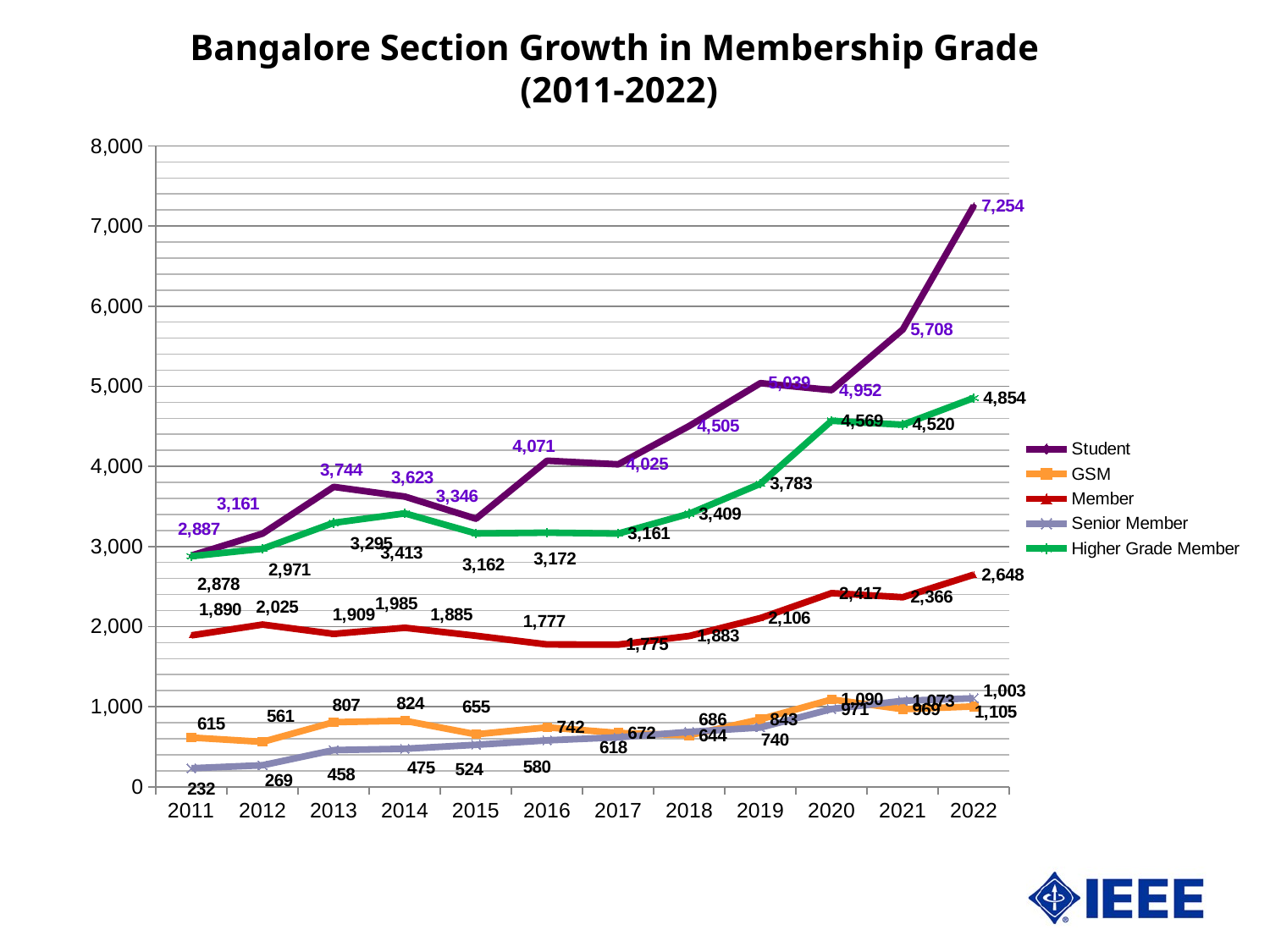
What is the Higher Grade Member value for 2019? 3,783 How many years are plotted along the x axis? 12 What kind of chart is shown on the slide? line chart What is the Member value for 2012? 2,025 In which year is the Senior Member series lowest? 2011 What is the GSM value for 2014? 824 In which year is the Student series highest? 2022 What is the difference between the Student values for 2022 and 2021? 1,546 How many series does the legend list? 5 Is the Member value for 2022 greater or less than 3,000? less In 2020, which is larger: Higher Grade Member or Member? Higher Grade Member What is the Student value for 2022? 7,254